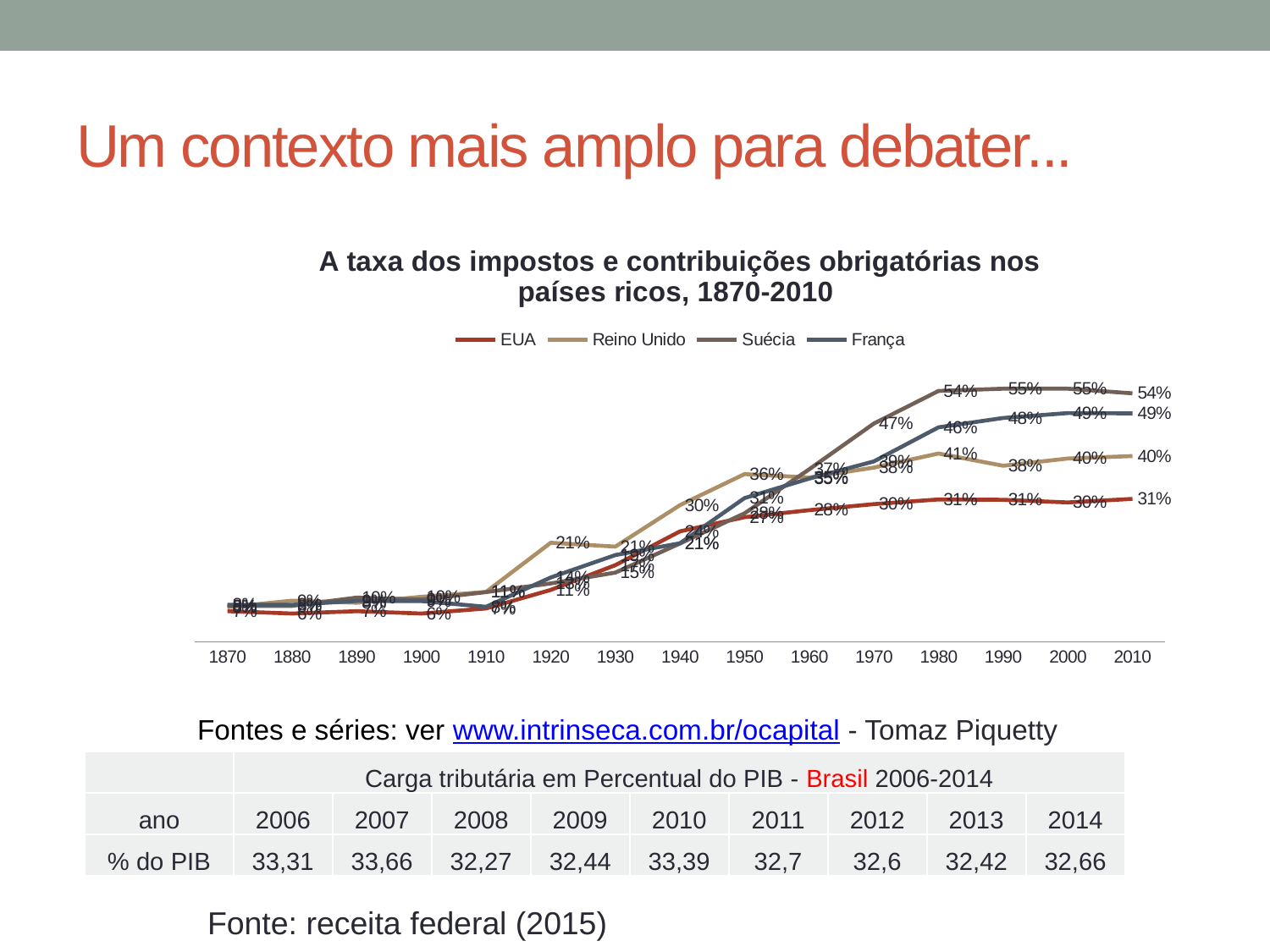
What is the value for Suécia in 1970? 47% What type of chart is shown on the slide? line chart What is the value for França in 2010? 49% Which country has the highest value in 2010? Suécia What is the value for EUA in 2010? 31% Which is larger in 1990, the value for França or the value for Reino Unido? França How many series does the chart legend list? 4 What is the value for Suécia in 2010? 54% What is the value for Reino Unido in 2010? 40% What is the difference between Suécia and EUA in 2010? 23 percentage points Which country has the lowest value in 2010? EUA Overall, do the values for Suécia rise or fall from 1870 to 2010? rise